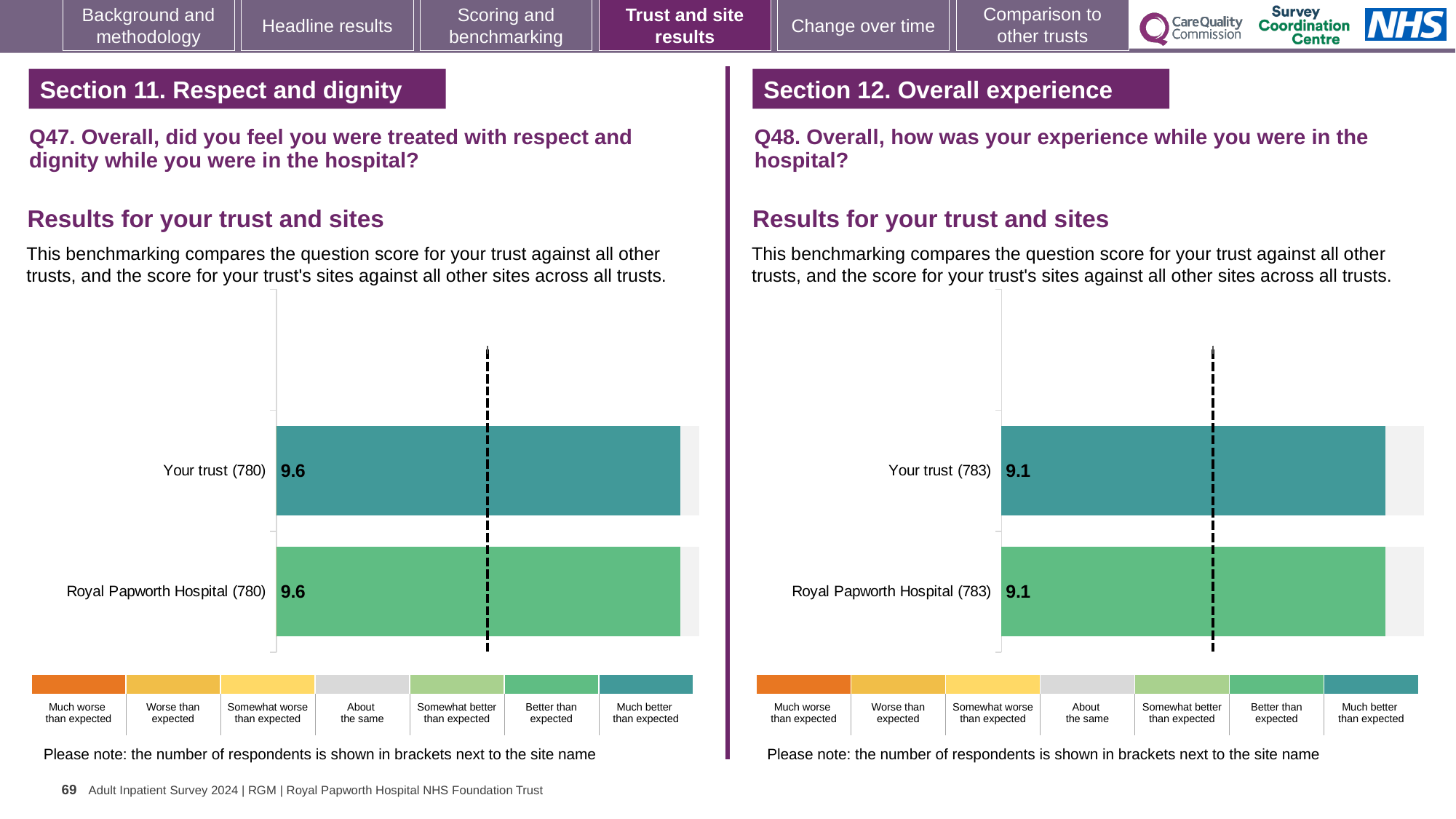
In the Q48 chart on the right, how many benchmark categories are listed in the colour key below the chart? 7 In the Q47 chart on the left, how many bars are plotted? 2 In the Q48 chart on the right, what is the score for Royal Papworth Hospital (783)? 9.1 In the Q47 chart on the left, what is the difference between the score for Your trust (780) and the score for Royal Papworth Hospital (780)? 0 In the Q48 chart on the right, how many bars are plotted? 2 What kind of chart is the Q48 chart on the right? Bar chart In the Q47 chart on the left, how many respondents are shown in brackets next to Your trust? 780 In the Q48 chart on the right, what is the score for Your trust (783)? 9.1 What kind of chart is the Q47 chart on the left? Bar chart In the Q48 chart on the right, what is the difference between the score for Your trust (783) and the score for Royal Papworth Hospital (783)? 0 In the Q47 chart on the left, what is the score for Your trust (780)? 9.6 In the Q47 chart on the left, what is the score for Royal Papworth Hospital (780)? 9.6